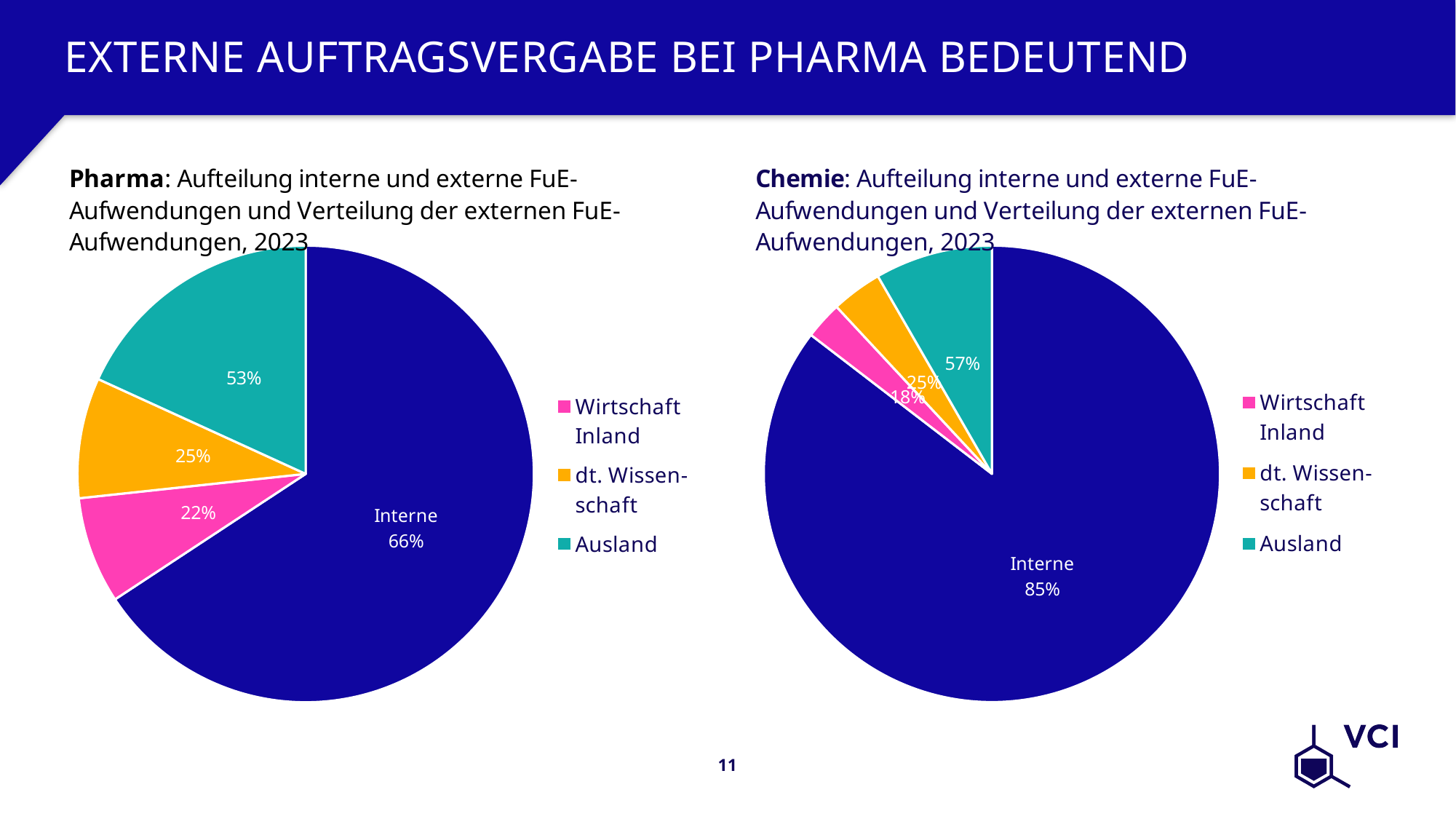
How many entries does the legend of the Pharma chart on the left list? 3 In the Pharma chart on the left, what value is printed on the Ausland slice? 53% In the Chemie chart on the right, what value is printed on the Ausland slice? 57% In the Chemie chart on the right, what percentage is shown for the Interne slice? 85% Which chart shows the larger Interne share, the Pharma chart or the Chemie chart? Chemie What type of chart is used on this slide? Pie chart In the Pharma chart on the left, which slice is the largest? Interne In the Pharma chart on the left, what value is printed on the dt. Wissenschaft slice? 25% What is the difference between the Interne percentage in the Chemie chart and the Interne percentage in the Pharma chart? 19% In the Chemie chart on the right, what value is printed on the Wirtschaft Inland slice? 18% In the Pharma chart on the left, what percentage is shown for the Interne slice? 66% In the Chemie chart on the right, which slice is the smallest? Wirtschaft Inland